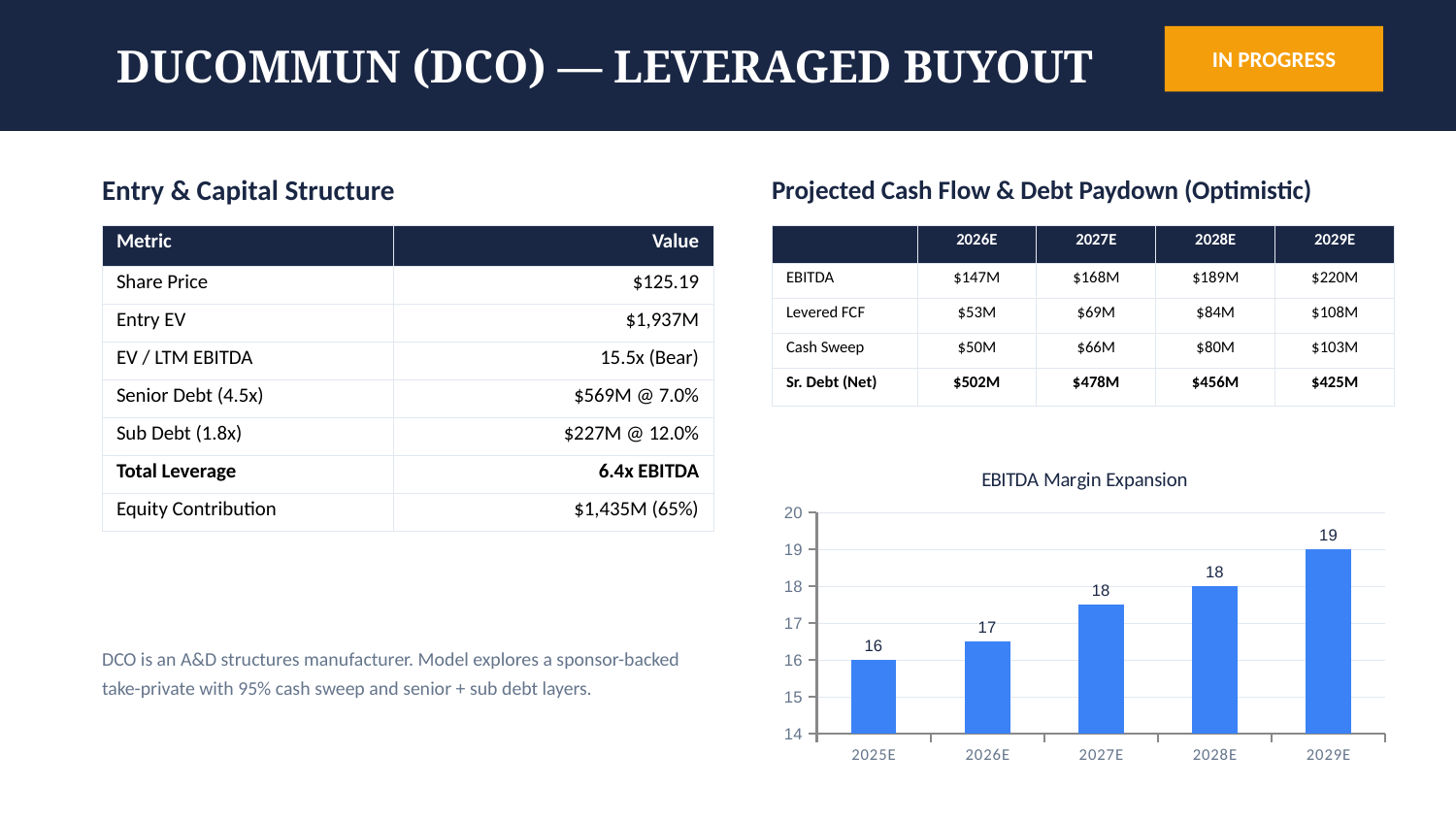
What is the title of the chart on the slide? EBITDA Margin Expansion What is the difference between the 2029E and 2025E values on the EBITDA Margin Expansion chart? 3 What kind of chart is the EBITDA Margin Expansion chart? bar chart What is the value shown for 2025E on the EBITDA Margin Expansion chart? 16 How many years are plotted on the EBITDA Margin Expansion chart? 5 Which year has the highest value on the EBITDA Margin Expansion chart? 2029E What is the value shown for 2029E on the EBITDA Margin Expansion chart? 19 What is the value shown for 2026E on the EBITDA Margin Expansion chart? 17 On the EBITDA Margin Expansion chart, which is larger, the value for 2029E or the value for 2026E? 2029E On the EBITDA Margin Expansion chart, is the value for 2025E greater or less than 17? less Which year has the lowest value on the EBITDA Margin Expansion chart? 2025E Do the values on the EBITDA Margin Expansion chart rise or fall from 2025E to 2029E? rise